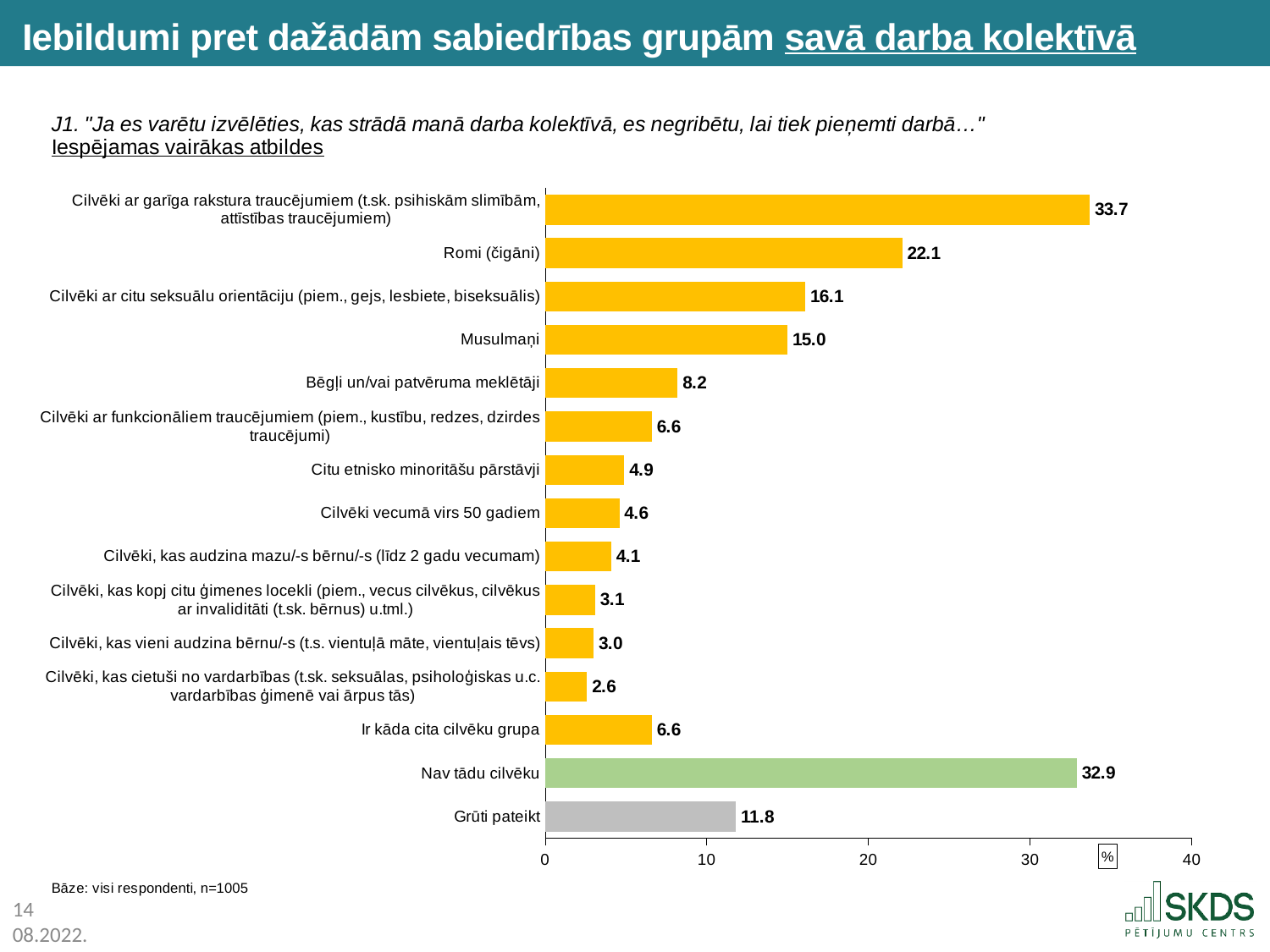
How many categories are shown in the chart? 15 What kind of chart is shown on the slide? bar chart What is the difference between the values for "Musulmaņi" and "Bēgļi un/vai patvēruma meklētāji"? 6.8 What is the value for "Nav tādu cilvēku"? 32.9 What is the difference between the values for "Romi (čigāni)" and "Cilvēki ar citu seksuālu orientāciju (piem., gejs, lesbiete, biseksuālis)"? 6.0 Which category has the highest value? Cilvēki ar garīga rakstura traucējumiem (t.sk. psihiskām slimībām, attīstības traucējumiem) What is the value for "Romi (čigāni)"? 22.1 What is the value for "Grūti pateikt"? 11.8 Is the value for "Grūti pateikt" greater or less than 10? greater Which is larger, the value for "Romi (čigāni)" or the value for "Musulmaņi"? Romi (čigāni) What is the value for "Musulmaņi"? 15.0 Which category has the lowest value? Cilvēki, kas cietuši no vardarbības (t.sk. seksuālas, psiholoģiskas u.c. vardarbības ģimenē vai ārpus tās)